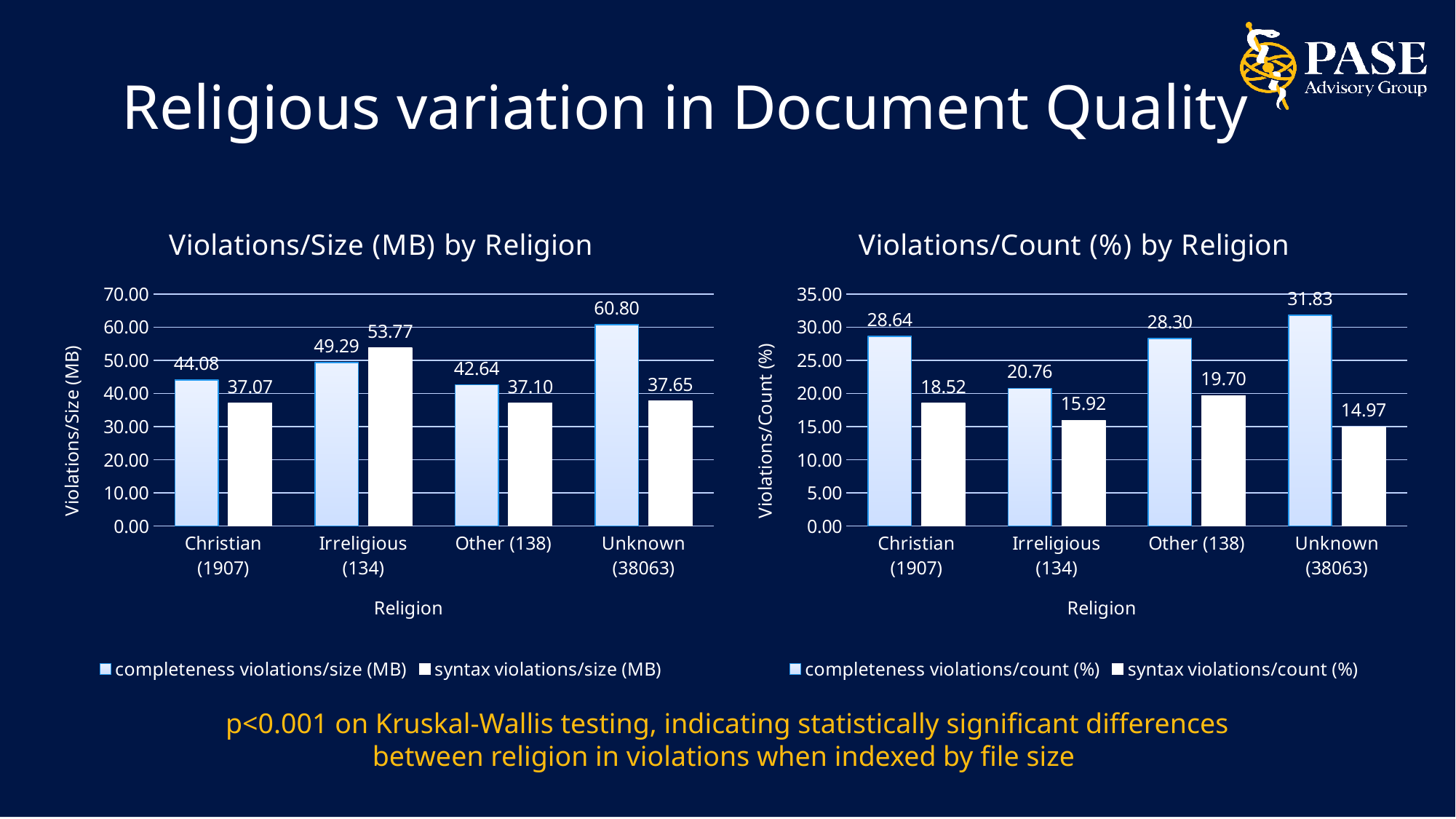
What type of chart is the 'Violations/Size (MB) by Religion' chart? Bar chart In the 'Violations/Count (%) by Religion' chart, is the syntax violations/count (%) value for Irreligious (134) greater or less than 20.00? less In the 'Violations/Count (%) by Religion' chart, what is the difference between the completeness and syntax violations/count (%) values for Unknown (38063)? 16.86 How many religion categories are shown on the x axis of the 'Violations/Size (MB) by Religion' chart? 4 In the 'Violations/Size (MB) by Religion' chart, which is larger for Irreligious (134): completeness violations/size (MB) or syntax violations/size (MB)? syntax violations/size (MB) In the 'Violations/Size (MB) by Religion' chart, which religion category has the lowest completeness violations/size (MB)? Other (138) In the 'Violations/Size (MB) by Religion' chart, what is the completeness violations/size (MB) value for Unknown (38063)? 60.80 What is the y-axis label of the 'Violations/Count (%) by Religion' chart? Violations/Count (%) In the 'Violations/Size (MB) by Religion' chart, what is the syntax violations/size (MB) value for Irreligious (134)? 53.77 How many series does the legend of the 'Violations/Count (%) by Religion' chart list? 2 In the 'Violations/Count (%) by Religion' chart, which religion category has the highest completeness violations/count (%)? Unknown (38063) In the 'Violations/Count (%) by Religion' chart, what is the syntax violations/count (%) value for Christian (1907)? 18.52